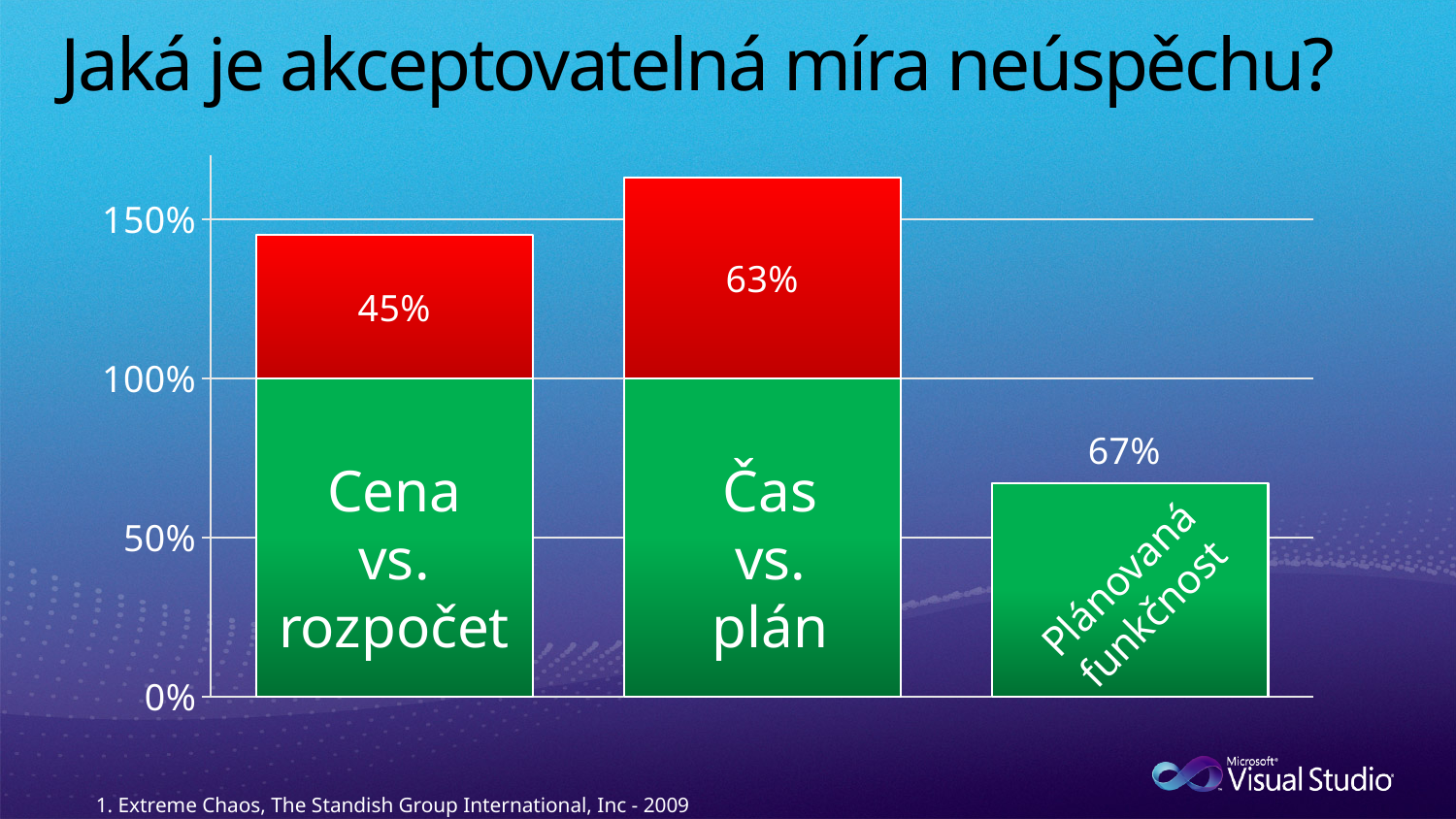
Which category has the shortest bar? Plánovaná funkčnost Which has the larger red segment, 'Cena vs. rozpočet' or 'Čas vs. plán'? Čas vs. plán What value is printed above the 'Plánovaná funkčnost' bar? 67% How many categories are shown on the x axis? 3 Which category has the tallest bar overall? Čas vs. plán What is the total height of the 'Cena vs. rozpočet' bar, with the green segment reaching 100% and the red segment at 45%? 145% What value is printed on the red segment of the 'Cena vs. rozpočet' bar? 45% What value is printed on the red segment of the 'Čas vs. plán' bar? 63% What kind of chart is shown on the slide? Stacked bar chart Is the value for 'Plánovaná funkčnost' greater or less than 100%? less What is the title of the slide? Jaká je akceptovatelná míra neúspěchu? What is the difference between the red segment values of 'Čas vs. plán' and 'Cena vs. rozpočet'? 18 percentage points